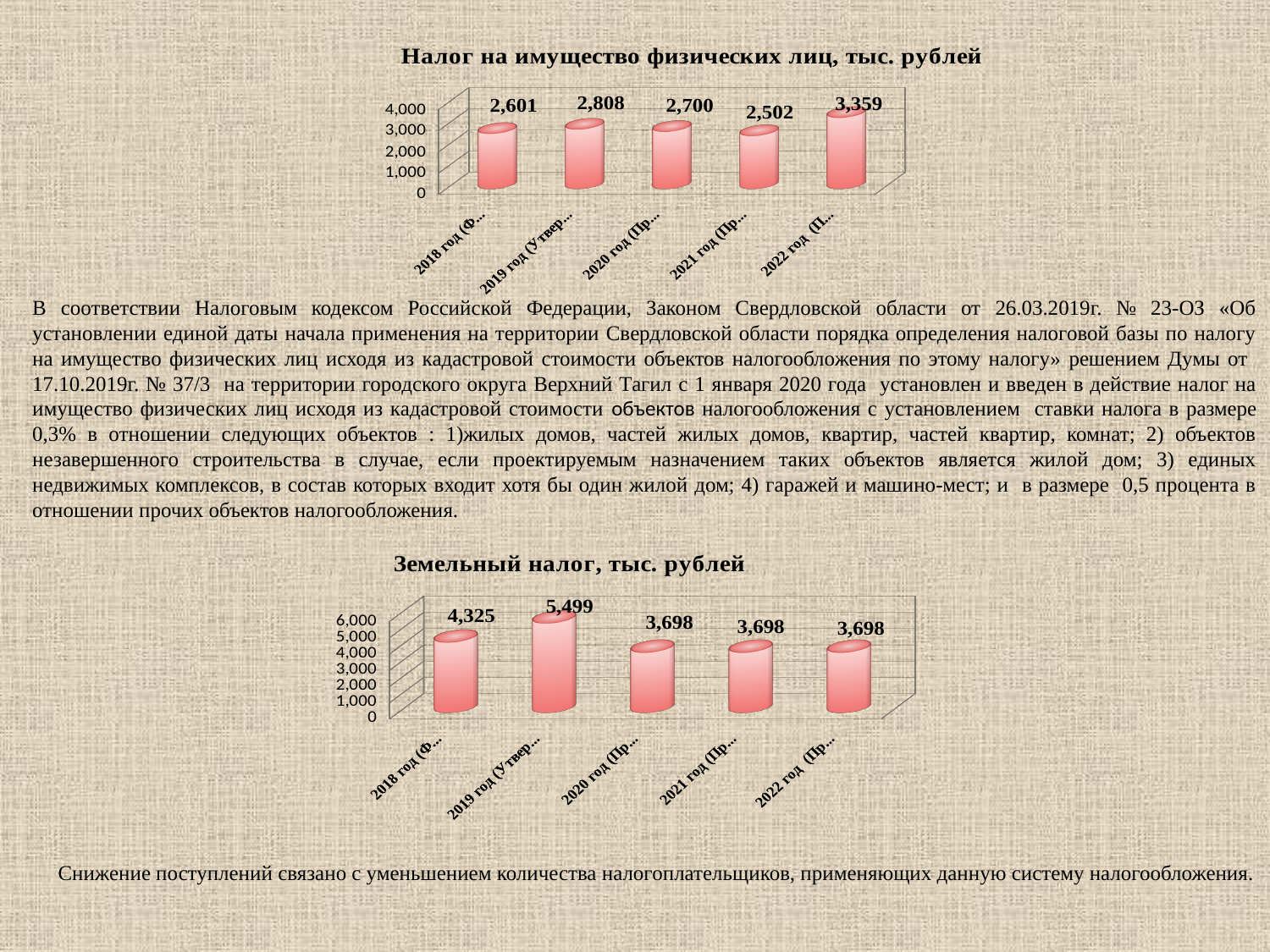
In the chart 'Земельный налог, тыс. рублей', what is the value for 2019 год? 5,499 In the chart 'Налог на имущество физических лиц, тыс. рублей', what is the value for 2022 год? 3,359 In the chart 'Налог на имущество физических лиц, тыс. рублей', how many bars are plotted? 5 In the chart 'Налог на имущество физических лиц, тыс. рублей', what is the value for 2018 год? 2,601 What kind of chart is 'Земельный налог, тыс. рублей'? Bar chart In the chart 'Земельный налог, тыс. рублей', what is the difference between the values for 2019 год and 2018 год? 1,174 In the chart 'Земельный налог, тыс. рублей', what is the value for 2021 год? 3,698 In the chart 'Налог на имущество физических лиц, тыс. рублей', what is the difference between the values for 2022 год and 2021 год? 857 In the chart 'Земельный налог, тыс. рублей', which year has the highest value? 2019 год In the chart 'Налог на имущество физических лиц, тыс. рублей', which year has the highest value? 2022 год In the chart 'Налог на имущество физических лиц, тыс. рублей', which year has the lowest value? 2021 год In the chart 'Земельный налог, тыс. рублей', is the value for 2018 год greater or less than 4,000? greater